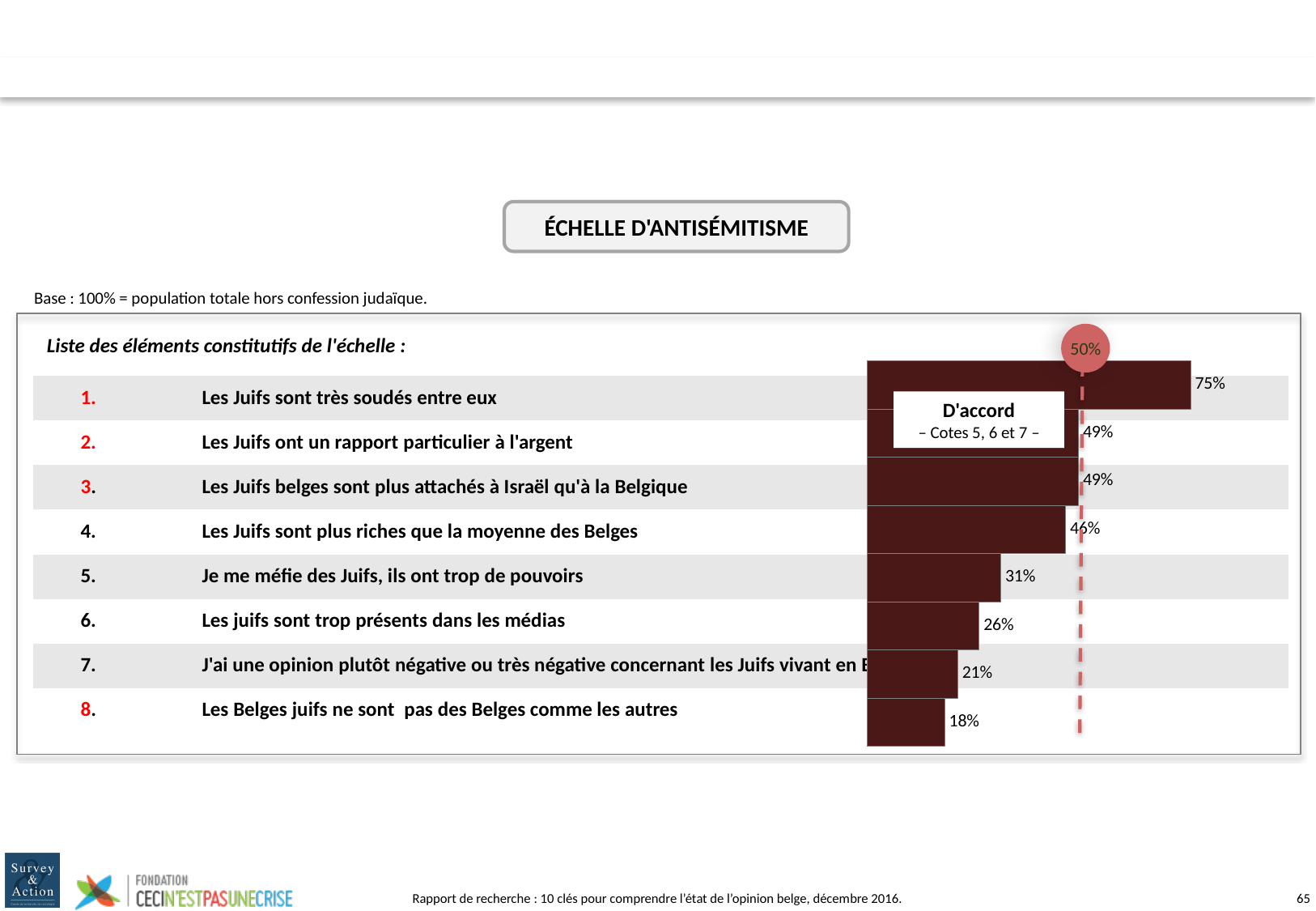
Which statement has the lowest agreement percentage? Les Belges juifs ne sont pas des Belges comme les autres What percentage agrees with the statement "Les Juifs sont très soudés entre eux"? 75% What kind of chart is shown on the slide? bar chart Which statement has the highest agreement percentage? Les Juifs sont très soudés entre eux What is the value shown for "Les juifs sont trop présents dans les médias"? 26% What is the difference in percentage points between "Les Juifs sont très soudés entre eux" and "Les Juifs sont plus riches que la moyenne des Belges"? 29 What is the value shown for "Je me méfie des Juifs, ils ont trop de pouvoirs"? 31% How many statements are plotted in the chart? 8 Which has a higher value: "Les Juifs sont plus riches que la moyenne des Belges" or "Je me méfie des Juifs, ils ont trop de pouvoirs"? Les Juifs sont plus riches que la moyenne des Belges What is the value shown for "Les Belges juifs ne sont pas des Belges comme les autres"? 18% Is the value for "Les Juifs ont un rapport particulier à l'argent" greater or less than 50%? less What value does the dashed vertical reference line mark on the chart? 50%